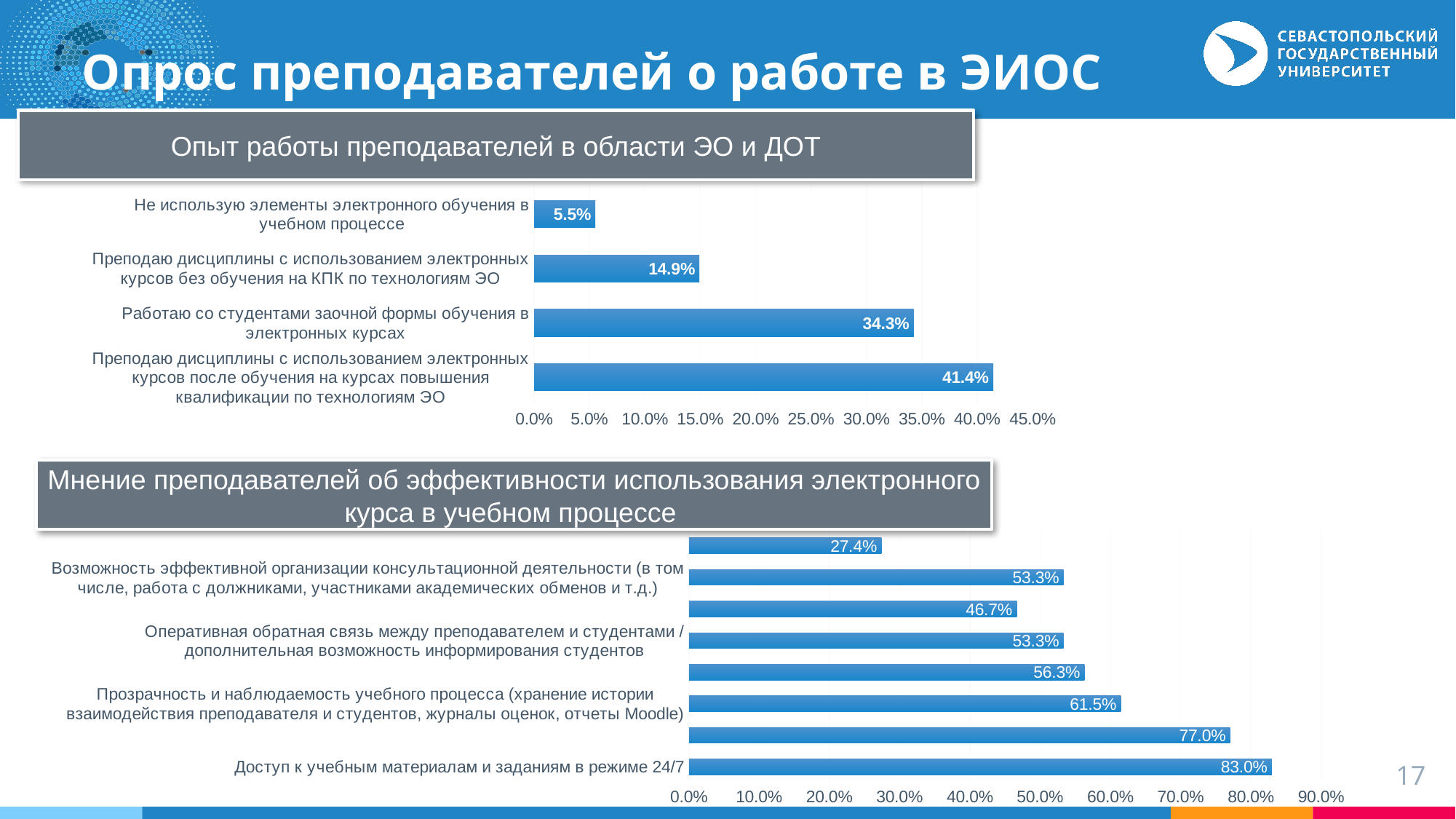
In the top chart 'Опыт работы преподавателей в области ЭО и ДОТ', what is the value for 'Не использую элементы электронного обучения в учебном процессе'? 5.5% In the top chart 'Опыт работы преподавателей в области ЭО и ДОТ', what is the value for 'Работаю со студентами заочной формы обучения в электронных курсах'? 34.3% In the bottom chart 'Мнение преподавателей об эффективности использования электронного курса в учебном процессе', how many bars are plotted? 8 In the bottom chart 'Мнение преподавателей об эффективности использования электронного курса в учебном процессе', what is the highest value shown? 83.0% What kind of chart is the top chart 'Опыт работы преподавателей в области ЭО и ДОТ'? Bar chart In the top chart 'Опыт работы преподавателей в области ЭО и ДОТ', which category has the highest value? Преподаю дисциплины с использованием электронных курсов после обучения на курсах повышения квалификации по технологиям ЭО In the bottom chart 'Мнение преподавателей об эффективности использования электронного курса в учебном процессе', what is the lowest value shown? 27.4% In the top chart 'Опыт работы преподавателей в области ЭО и ДОТ', what is the difference between the values for 'Преподаю дисциплины с использованием электронных курсов после обучения на курсах повышения квалификации по технологиям ЭО' and 'Преподаю дисциплины с использованием электронных курсов без обучения на КПК по технологиям ЭО'? 26.5% In the bottom chart 'Мнение преподавателей об эффективности использования электронного курса в учебном процессе', is the value for 'Доступ к учебным материалам и заданиям в режиме 24/7' greater or less than 80.0%? greater In the bottom chart 'Мнение преподавателей об эффективности использования электронного курса в учебном процессе', what is the value for 'Доступ к учебным материалам и заданиям в режиме 24/7'? 83.0% In the top chart 'Опыт работы преподавателей в области ЭО и ДОТ', how many categories are shown? 4 In the top chart 'Опыт работы преподавателей в области ЭО и ДОТ', which category has the lowest value? Не использую элементы электронного обучения в учебном процессе